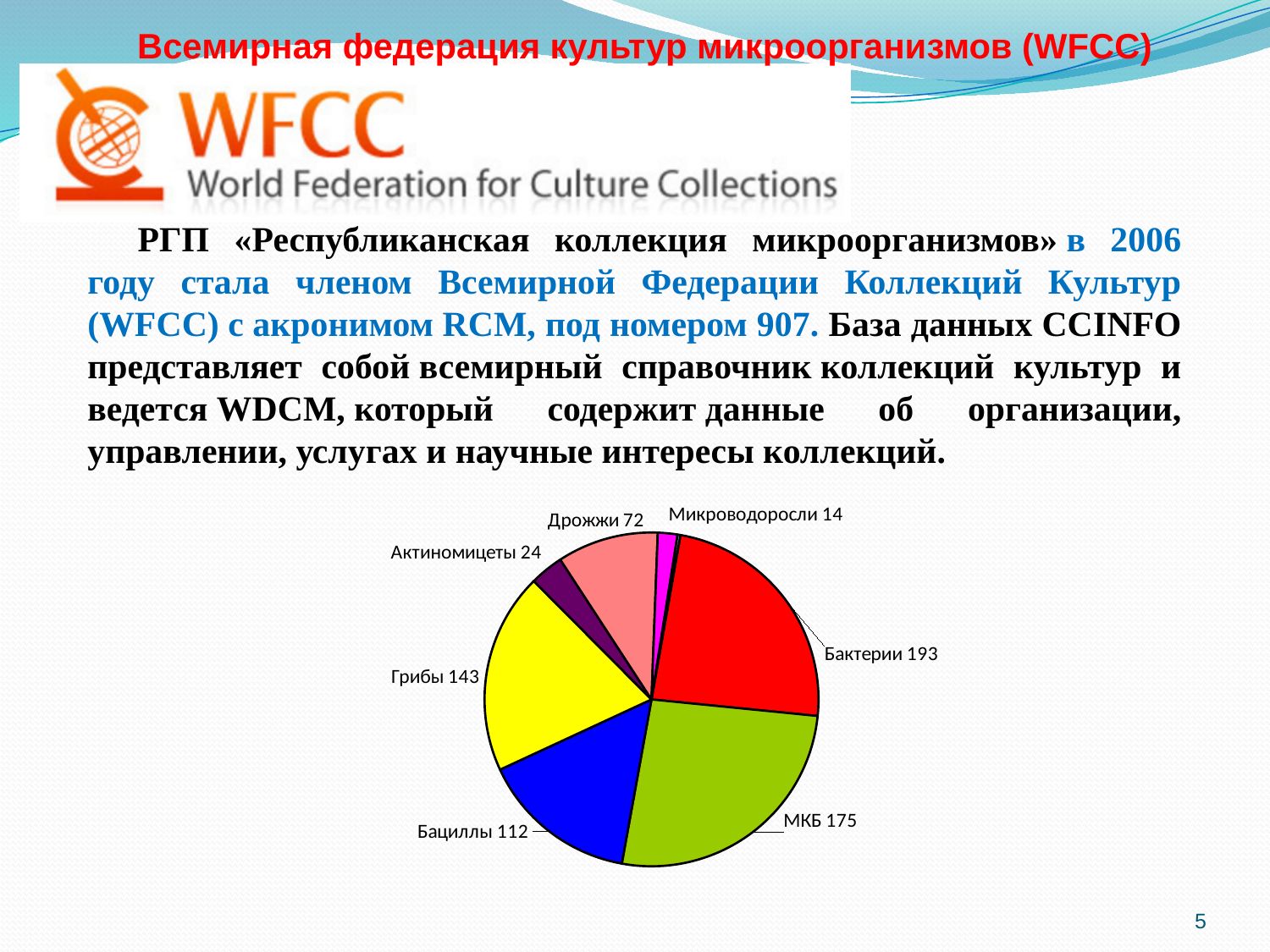
What kind of chart is shown on the slide? pie chart Which is larger, the value for Дрожжи or the value for Актиномицеты? Дрожжи What is the value for Бациллы in the pie chart? 112 What colour is the Грибы slice in the pie chart? yellow What is the difference between the values for Грибы and Бациллы? 31 What is the value for МКБ in the pie chart? 175 Which category has the smallest slice in the pie chart? Микроводоросли What is the value for Актиномицеты in the pie chart? 24 Which category has the largest slice in the pie chart? Бактерии What is the value for Грибы in the pie chart? 143 What is the difference between the values for Бактерии and МКБ? 18